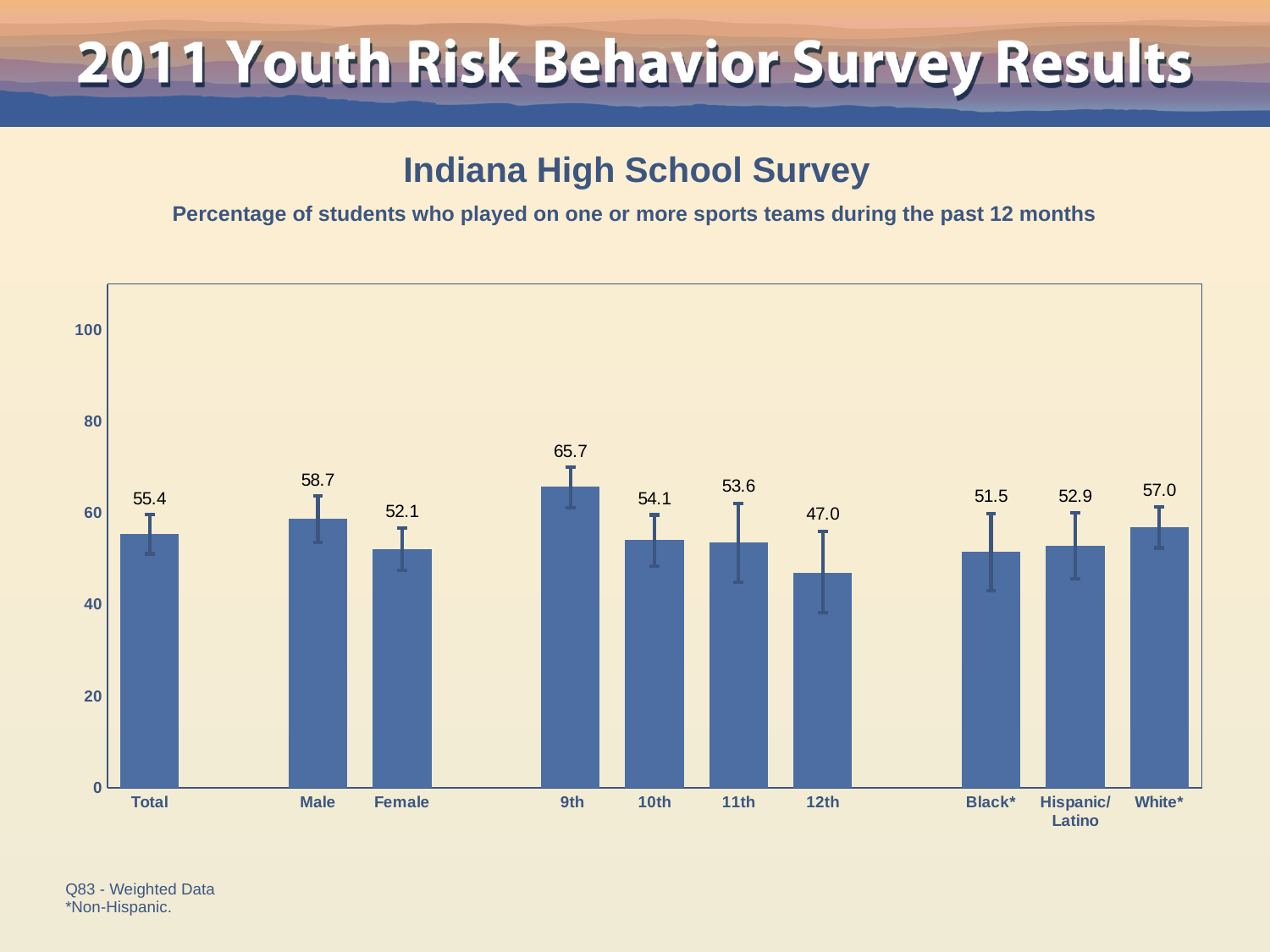
Which category has the lowest value? 12th Is the value for 12th greater or less than 60? less What is the difference between the values for 9th and 12th? 18.7 Do the values rise or fall from 9th to 12th grade? fall What is the value for 9th grade students? 65.7 Which is larger, the value for White* or the value for Black*? White* What is the value for Total? 55.4 Which category has the highest value? 9th What is the value for Hispanic/Latino students? 52.9 How many categories are shown on the x axis? 10 What is the difference between the values for Male and Female? 6.6 What kind of chart is this? bar chart